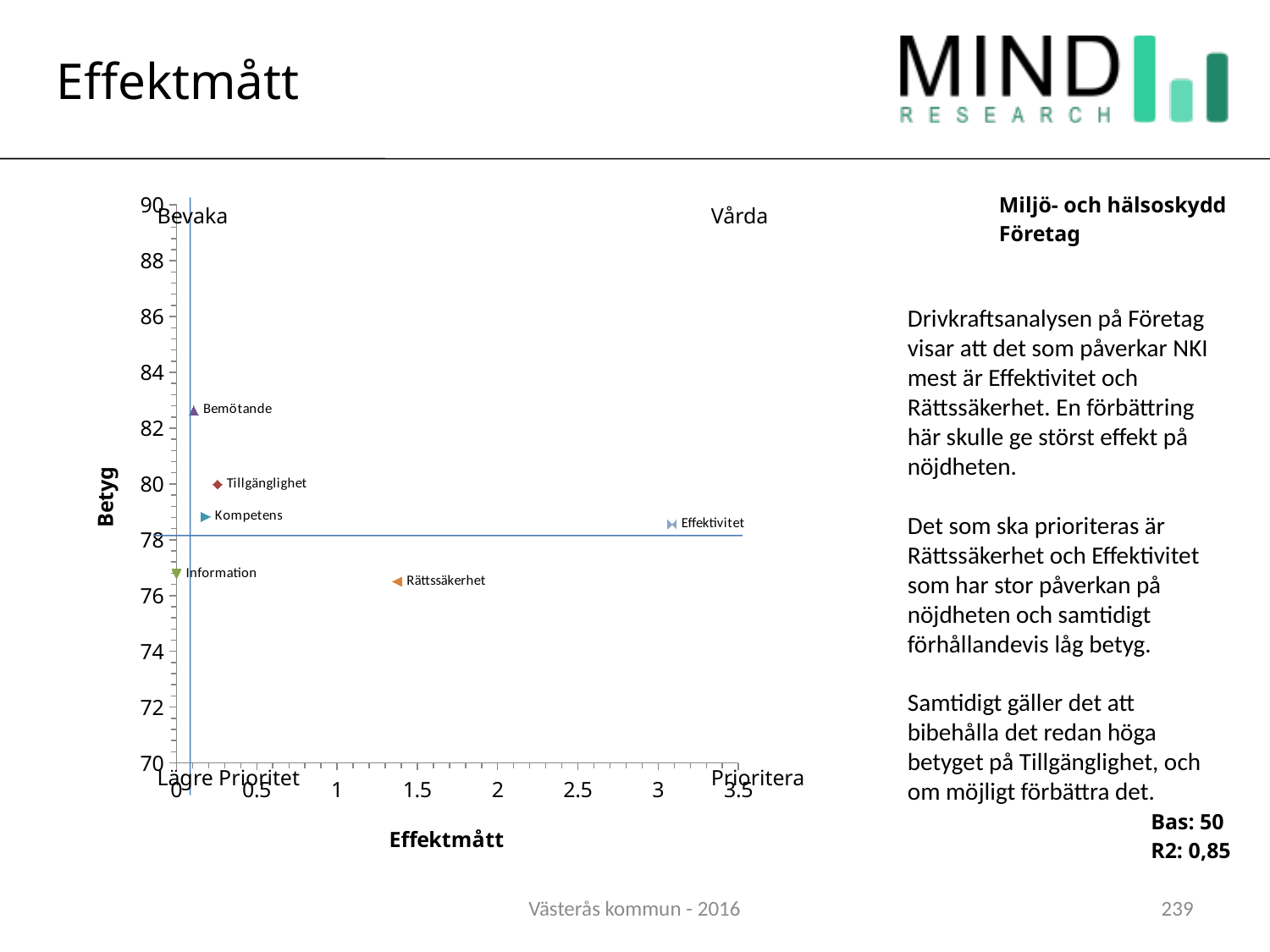
Which point has the highest Betyg value? Bemötande Is the Effektmått value for Effektivitet greater or less than 2.5? greater What is the title of the horizontal axis of the chart? Effektmått Is the Effektmått value for Rättssäkerhet greater or less than 1? greater What kind of chart is shown on the slide? scatter chart Is the Betyg value for Bemötande greater or less than 82? greater Which point has the lowest Effektmått value? Information Which has a higher Effektmått value, Effektivitet or Rättssäkerhet? Effektivitet Which has a higher Betyg value, Bemötande or Tillgänglighet? Bemötande Which point has the highest Effektmått value? Effektivitet How many data points are plotted in the chart? 6